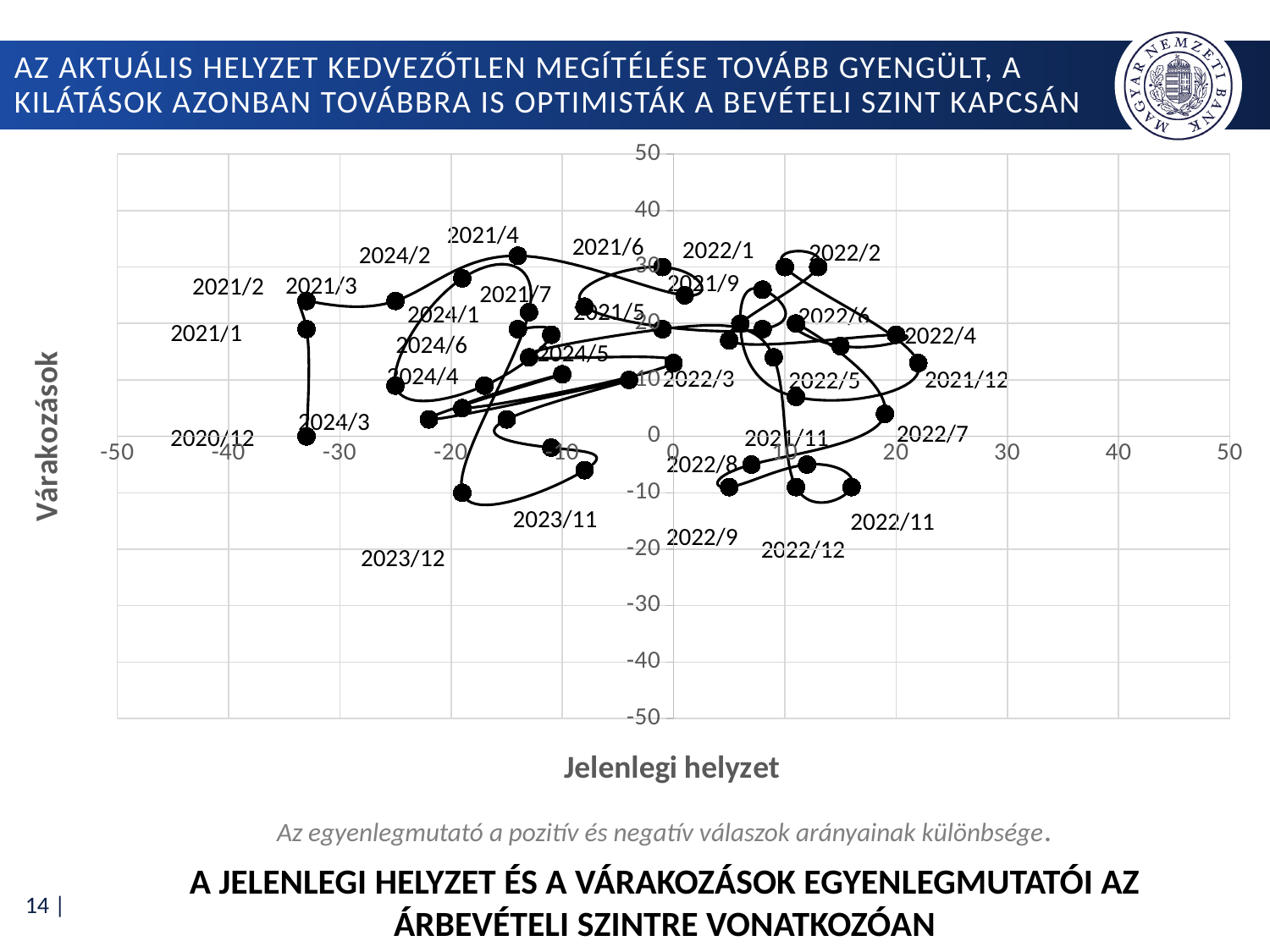
Which point has the higher horizontal-axis (Jelenlegi helyzet) value, 2022/7 or 2024/3? 2022/7 What is the title of the vertical axis of the chart? Várakozások Is the horizontal-axis (Jelenlegi helyzet) value for the point labelled 2022/4 greater or less than 10? greater Is the vertical-axis (Várakozások) value for the point labelled 2023/12 greater or less than 0? less What is the title of the horizontal axis of the chart? Jelenlegi helyzet What kind of chart is shown on the slide? scatter chart Is the horizontal-axis (Jelenlegi helyzet) value for the point labelled 2021/12 greater or less than 10? greater Which point has the higher vertical-axis (Várakozások) value, 2021/4 or 2022/11? 2021/4